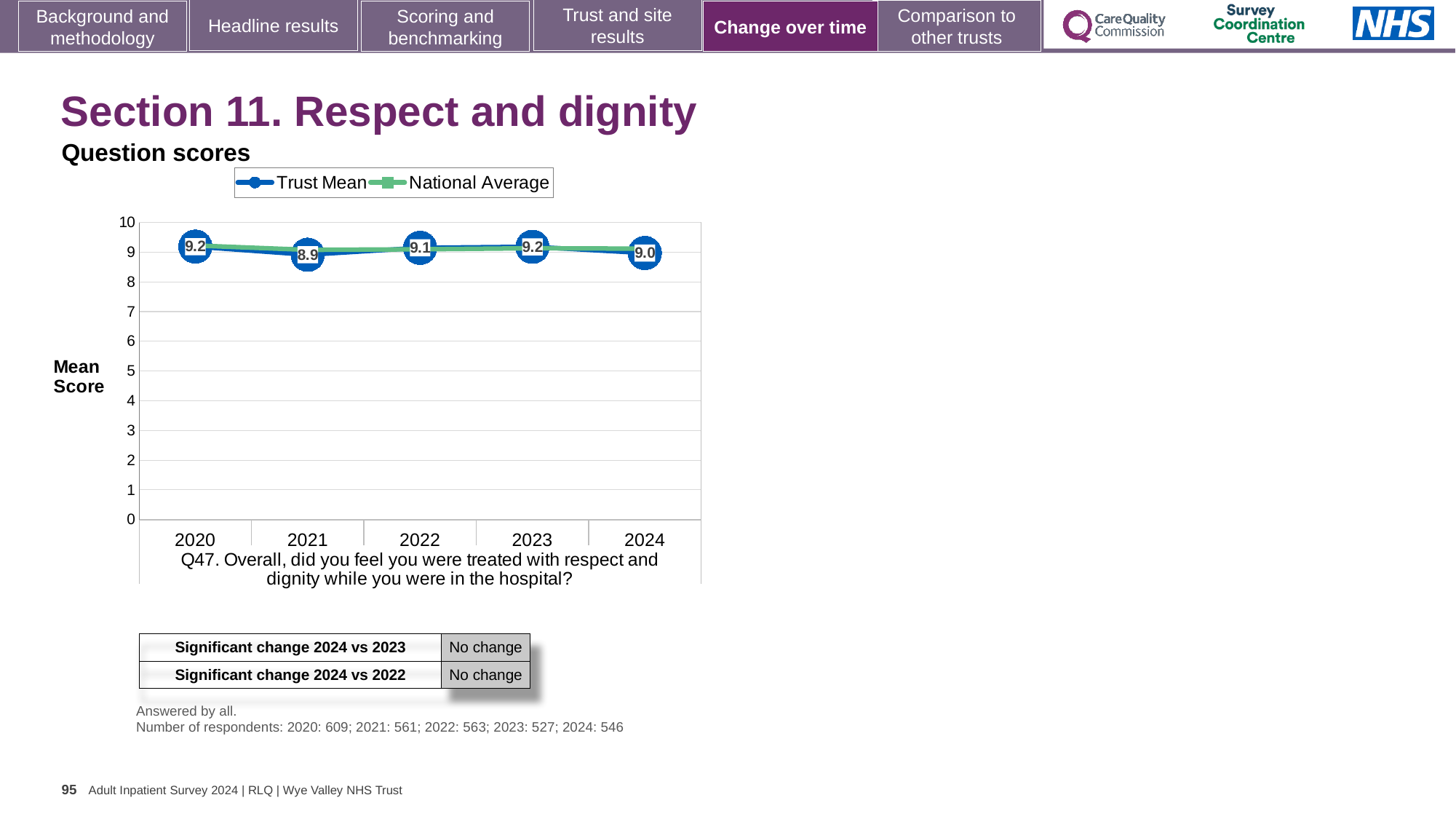
Is the National Average value for 2022 greater or less than 8? greater Which is larger, the Trust Mean score for 2021 or for 2023? 2023 What is the Trust Mean score for 2021? 8.9 In which year is the Trust Mean score lowest? 2021 What is the label of the y axis? Mean Score How many series does the legend list? 2 What is the Trust Mean score for 2024? 9.0 What kind of chart is shown on the slide? line chart What is the Trust Mean score for 2022? 9.1 Does the Trust Mean score rise or fall from 2023 to 2024? fall What is the difference between the Trust Mean scores for 2020 and 2021? 0.3 How many years are plotted on the x axis? 5